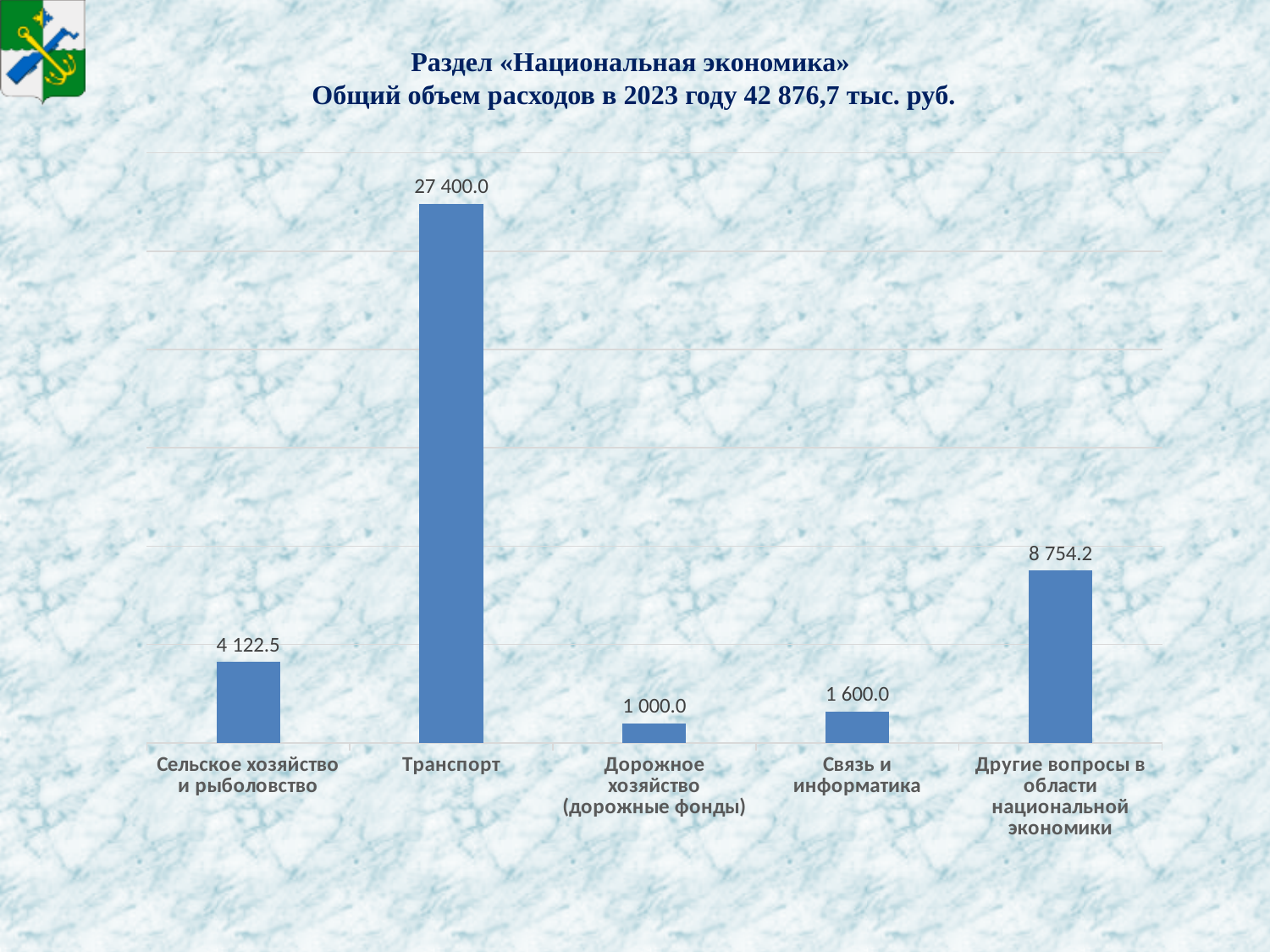
How many categories are shown in the chart? 5 What is the difference between the values for Связь и информатика and Дорожное хозяйство (дорожные фонды)? 600.0 What is the difference between the values for Транспорт and Другие вопросы в области национальной экономики? 18 645.8 What kind of chart is shown on the slide? Bar chart What is the value for Связь и информатика? 1 600.0 What is the value for Дорожное хозяйство (дорожные фонды)? 1 000.0 Which category has the highest value? Транспорт What is the value for Транспорт? 27 400.0 Which category has the lowest value? Дорожное хозяйство (дорожные фонды) Which is larger: the value for Сельское хозяйство и рыболовство or the value for Связь и информатика? Сельское хозяйство и рыболовство What is the value for Другие вопросы в области национальной экономики? 8 754.2 What is the value for Сельское хозяйство и рыболовство? 4 122.5